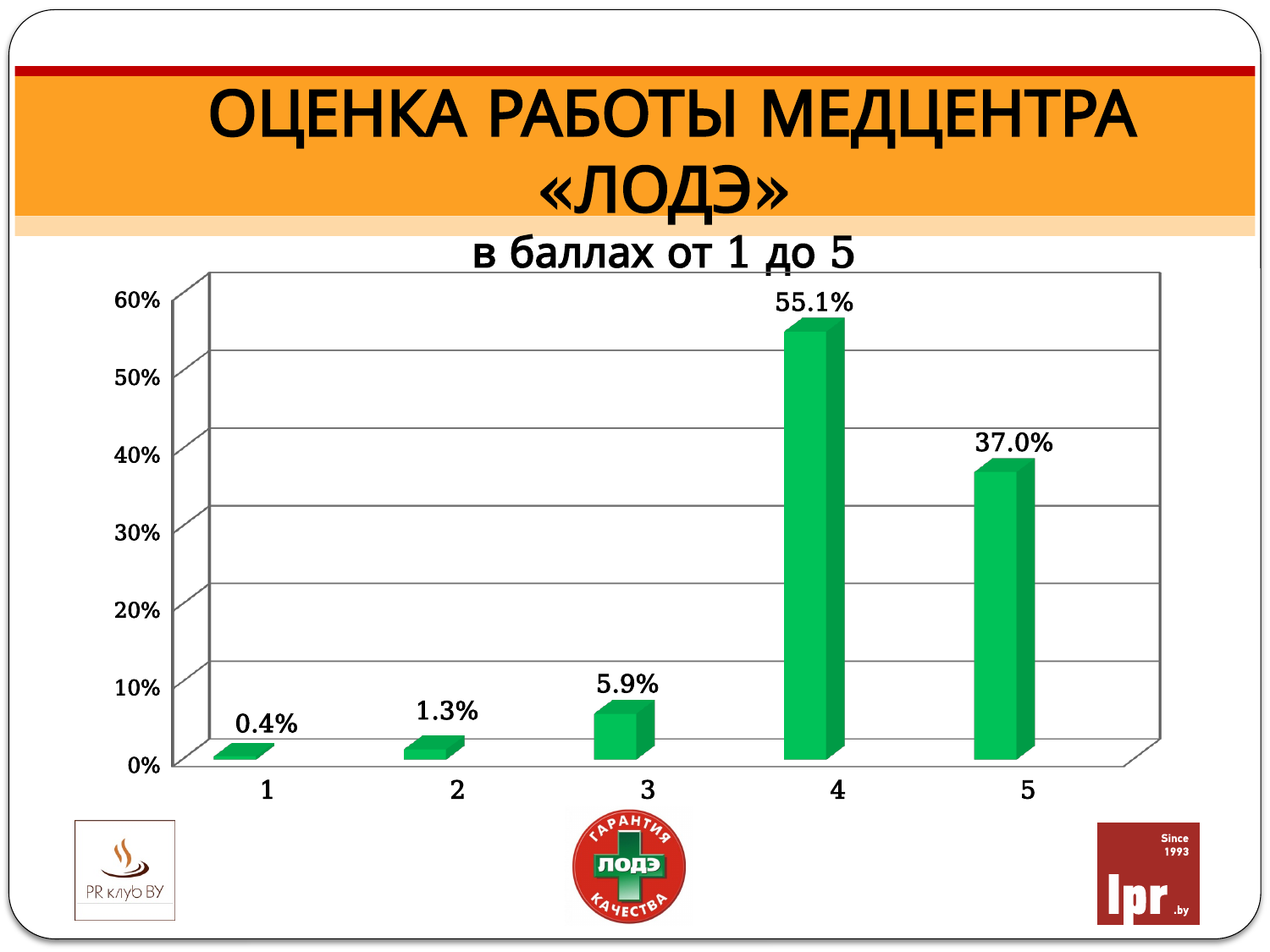
What percentage of respondents gave a score of 4? 55.1% What is the value shown for score 3? 5.9% Which has a larger percentage, score 2 or score 3? 3 What is the subtitle shown above the chart? в баллах от 1 до 5 What is the difference between the percentages for score 4 and score 5? 18.1% Which score received the lowest percentage? 1 How many score categories are shown on the x axis? 5 Is the value for score 5 greater or less than 40%? less What is the difference between the percentages for score 3 and score 2? 4.6% What percentage of respondents gave a score of 1? 0.4% Which score received the highest percentage? 4 What type of chart is shown on the slide? bar chart